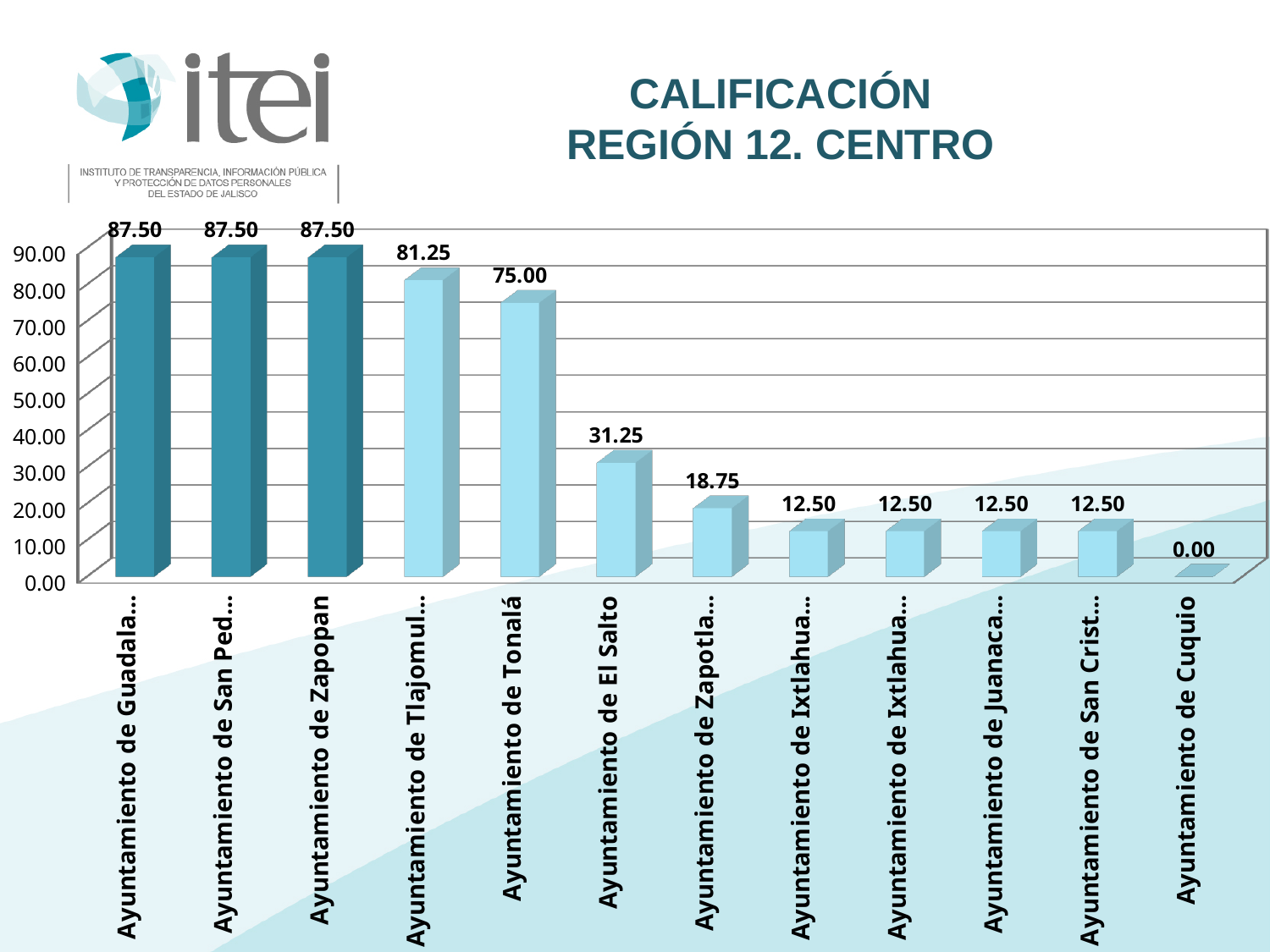
How many bars have a value of 87.50? 3 What is the value for Ayuntamiento de Tonalá? 75.00 Do the values rise or fall from left to right along the x axis? fall What is the difference between the values for Ayuntamiento de Zapopan and Ayuntamiento de Tonalá? 12.50 What is the difference between the values for Ayuntamiento de Tonalá and Ayuntamiento de El Salto? 43.75 What is the value for Ayuntamiento de El Salto? 31.25 What is the value for Ayuntamiento de Cuquio? 0.00 What kind of chart is shown on the slide? bar chart Which is larger, the value for Ayuntamiento de Tonalá or Ayuntamiento de El Salto? Ayuntamiento de Tonalá Which category has the lowest value? Ayuntamiento de Cuquio What is the value for Ayuntamiento de Zapopan? 87.50 How many bars are shown in the chart? 12